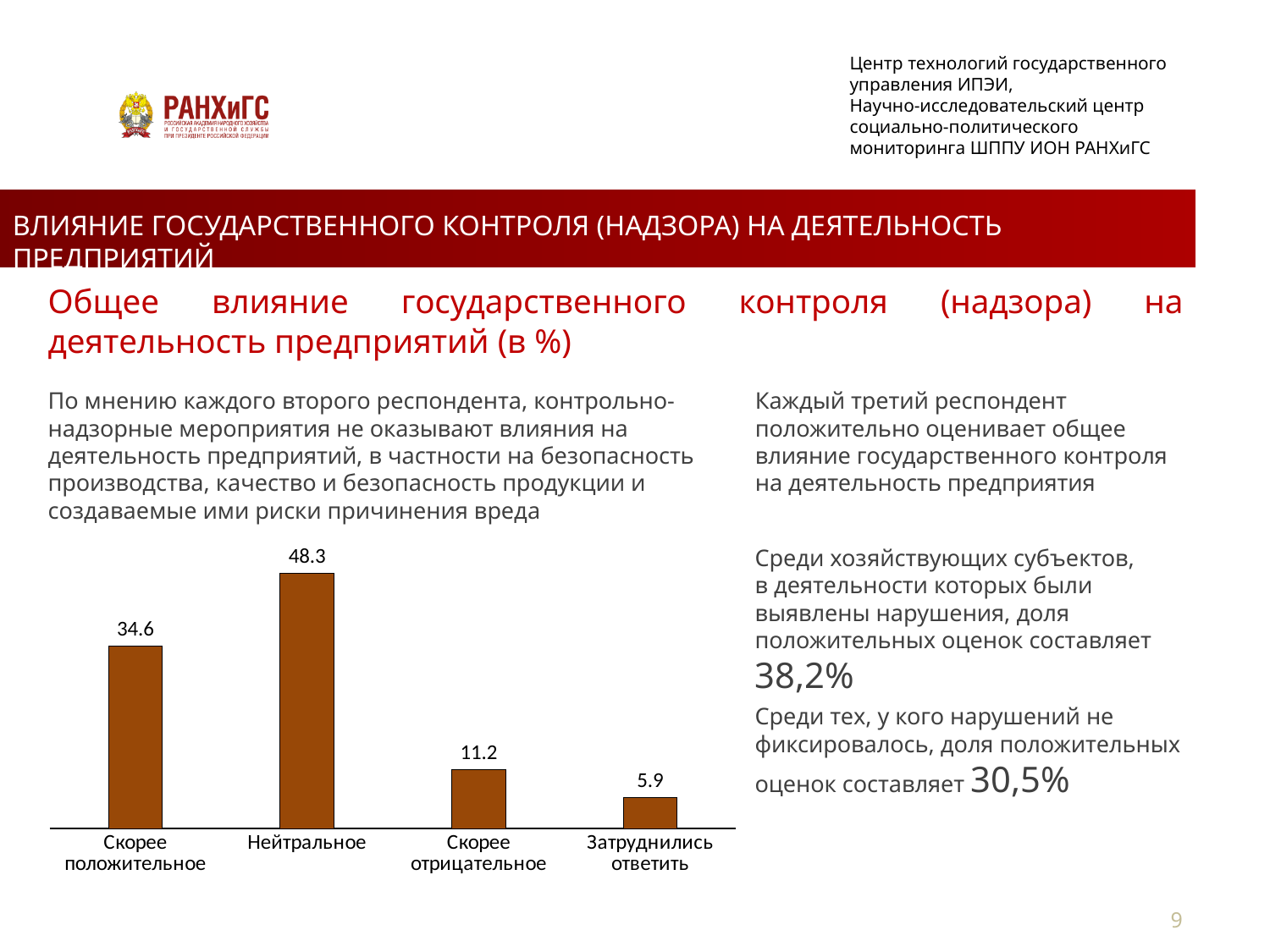
Which is larger: the value for 'Скорее положительное' or the value for 'Скорее отрицательное'? Скорее положительное How many categories are shown in the chart? 4 What is the value for the 'Нейтральное' category? 48.3 What colour are the bars in the chart? brown Which category has the highest value? Нейтральное What is the value for the 'Скорее отрицательное' category? 11.2 What is the value for the 'Скорее положительное' category? 34.6 What kind of chart is shown on the slide? bar chart What is the value for the 'Затруднились ответить' category? 5.9 What is the difference between the values for 'Скорее отрицательное' and 'Затруднились ответить'? 5.3 What is the difference between the values for 'Нейтральное' and 'Скорее положительное'? 13.7 Which category has the lowest value? Затруднились ответить